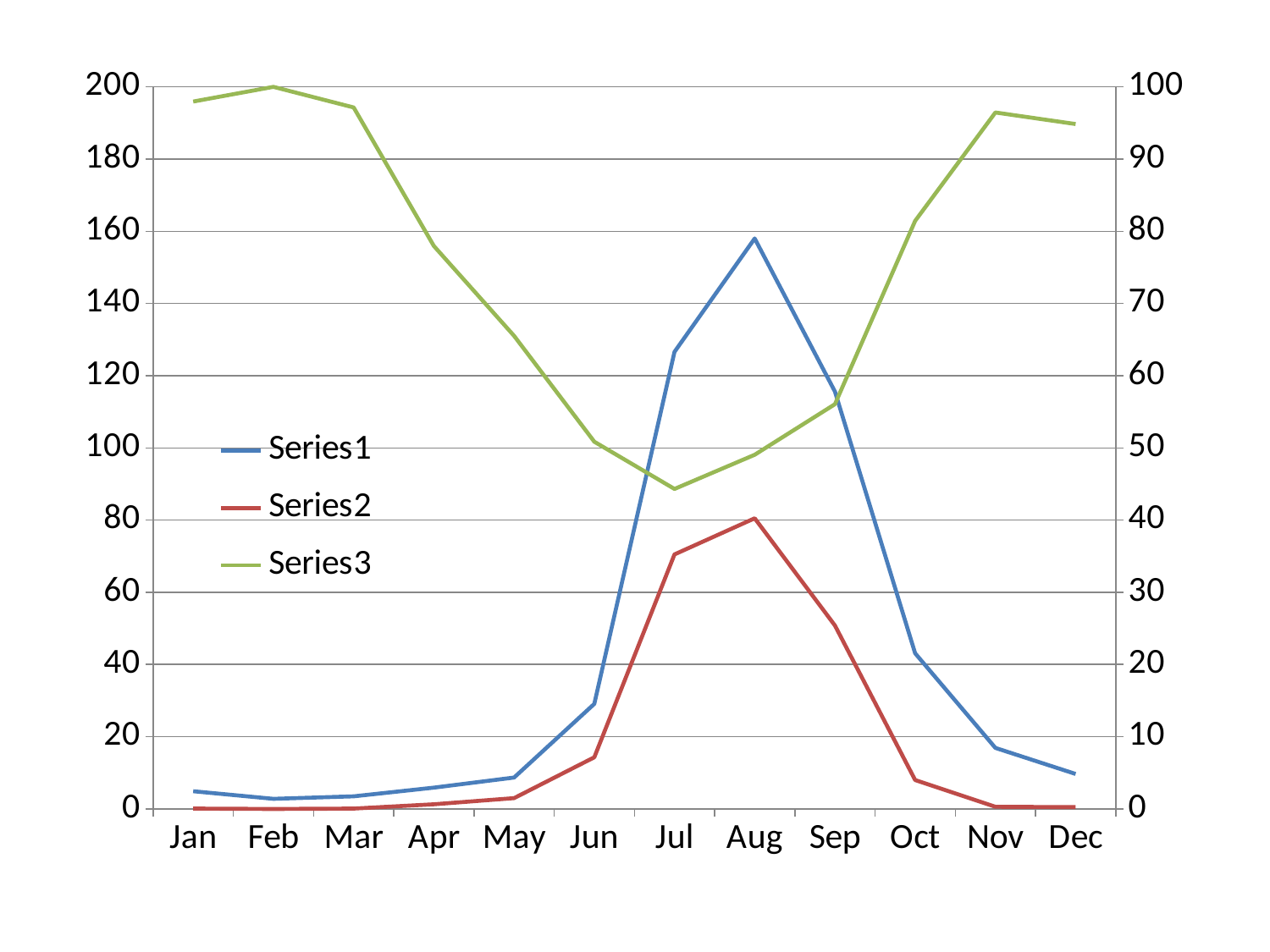
In which month does Series3 reach its highest value? Feb In which month does Series3 reach its lowest value? Jul How many series does the legend list? 3 How many months are plotted along the x axis? 12 Does Series3 rise or fall from Feb to Jul? Fall In which month does Series2 reach its highest value? Aug In Jul, which is higher, Series1 or Series2? Series1 What kind of chart is shown on the slide? Line chart Does Series1 rise or fall from May to Aug? Rise What colour is the line for Series3? Green In which month does Series1 reach its highest value? Aug Does Series1 rise or fall from Aug to Dec? Fall